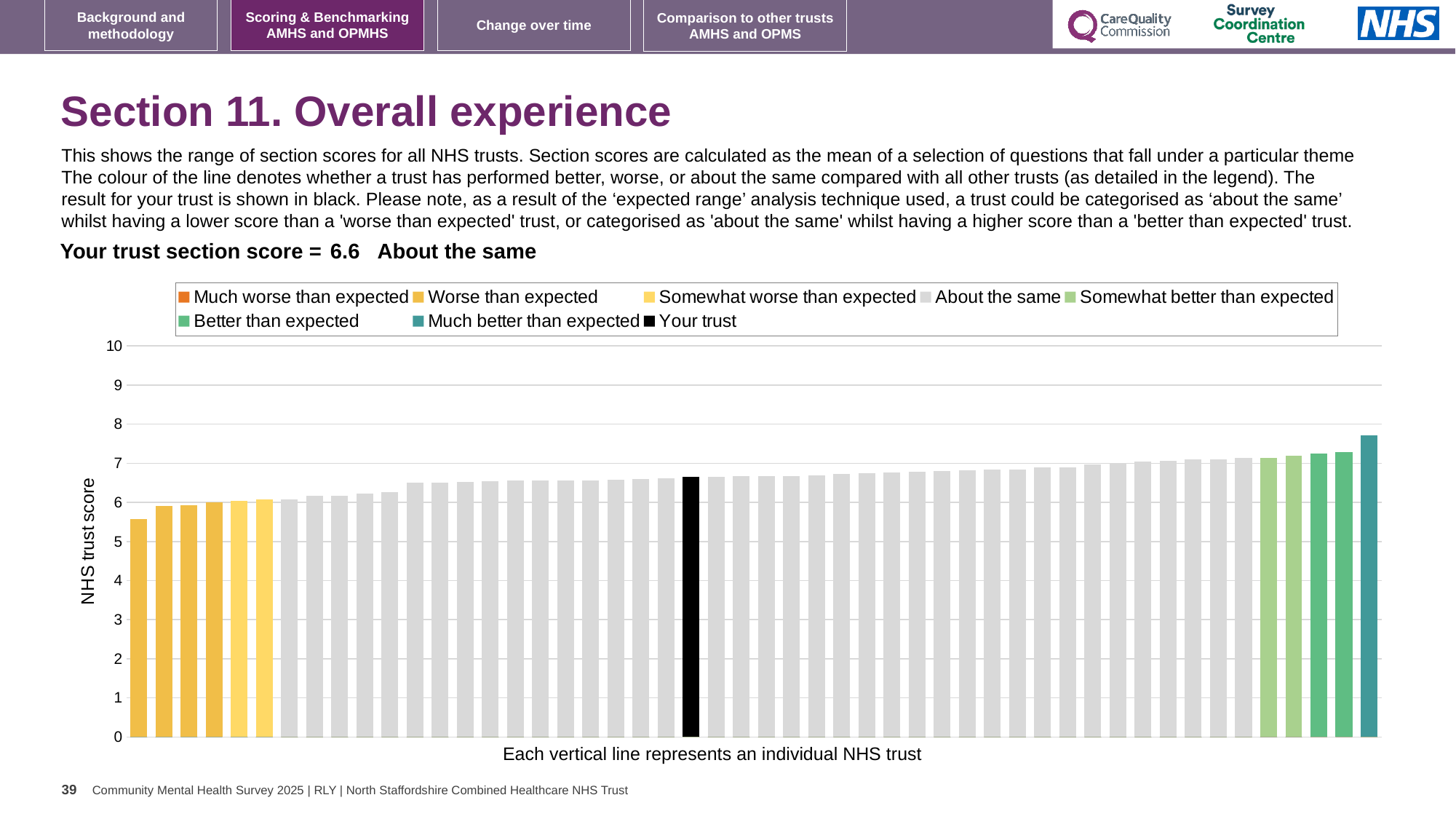
How many bars are coloured as 'Much better than expected'? 1 What is the title of the vertical axis? NHS trust score How many entries does the chart legend list? 8 What colour is used for the 'Your trust' bar? black What is the section score for your trust shown on the slide? 6.6 Which legend category does your trust fall into for this section? About the same Which legend category does the tallest bar belong to? Much better than expected Is the value of the black 'Your trust' bar greater or less than 5? greater Is the value of the tallest bar in the chart greater or less than 7? greater Do the bar values rise or fall from left to right along the x axis? rise Is the value of the shortest bar in the chart greater or less than 6? less What kind of chart is shown on the slide? bar chart